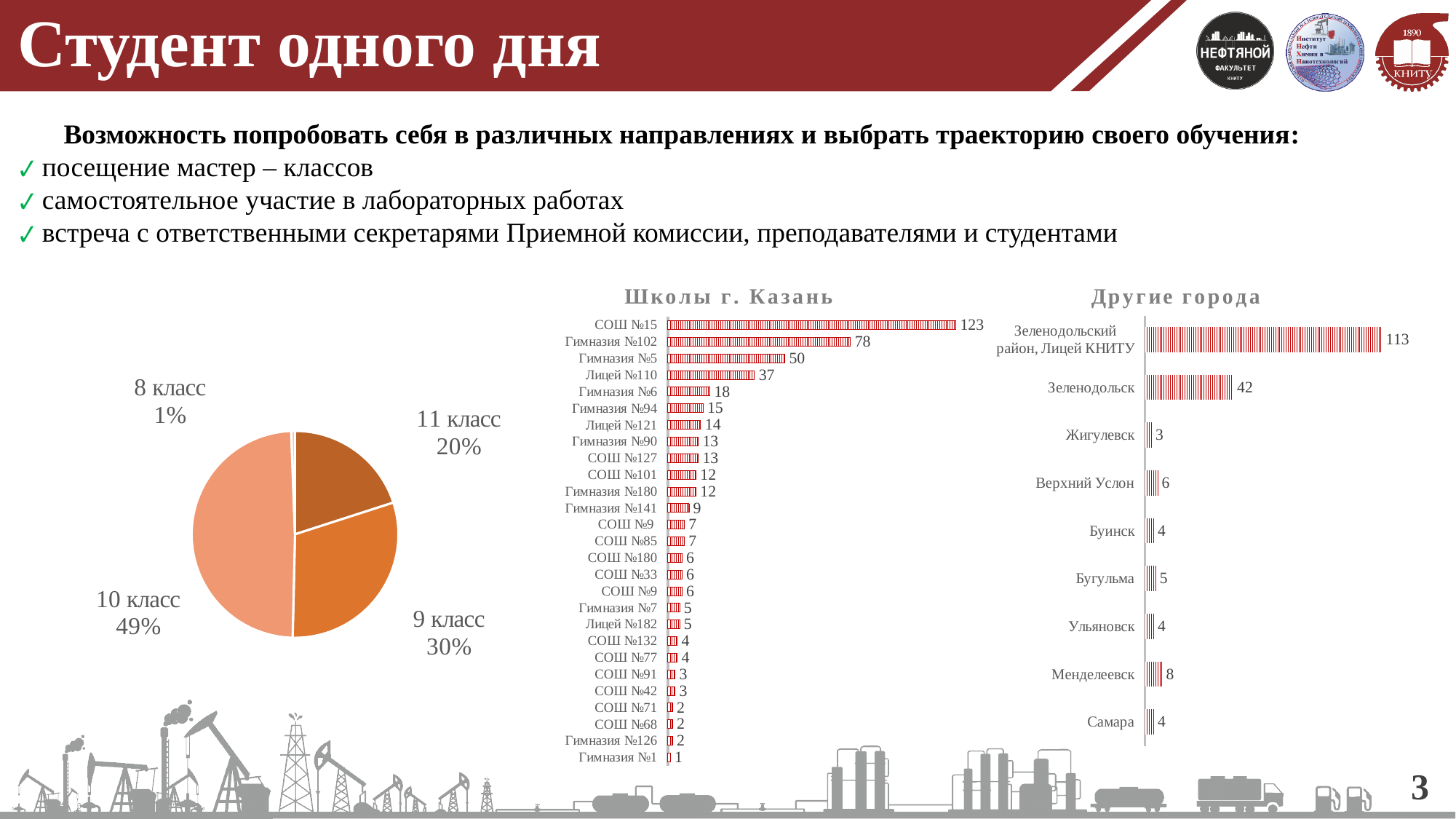
In the pie chart on the left, what is the difference between the shares of 9 класс and 11 класс? 10% In the chart titled 'Другие города', what is the difference between Менделеевск and Жигулевск? 5 In the chart titled 'Другие города', what is the value for Зеленодольск? 42 In the chart titled 'Другие города', which category has the highest value? Зеленодольский район, Лицей КНИТУ In the pie chart on the left, which class has the smallest slice? 8 класс In the chart titled 'Школы г. Казань', what is the difference between СОШ №15 and Гимназия №5? 73 In the chart titled 'Школы г. Казань', which school has the highest value? СОШ №15 In the chart titled 'Школы г. Казань', which is larger: Лицей №110 or Гимназия №6? Лицей №110 In the chart titled 'Другие города', how many categories are shown? 9 In the chart titled 'Школы г. Казань', what is the value for Гимназия №102? 78 In the pie chart on the left, what share is shown for 10 класс? 49% What kind of chart is the one titled 'Школы г. Казань'? Bar chart